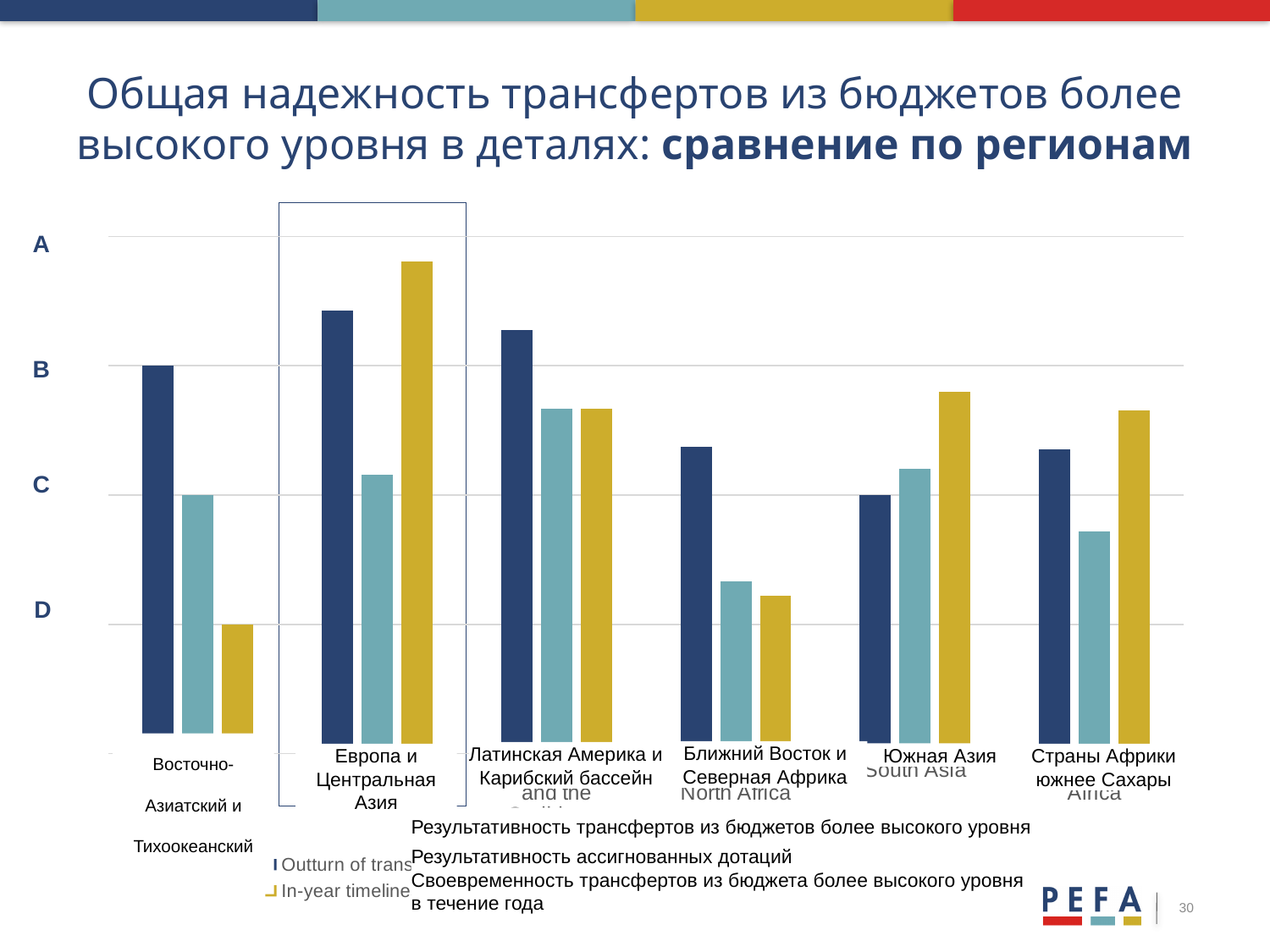
How many regions (categories) are shown on the x axis of the chart? 6 Which grade line does the dark blue bar for Южная Азия reach? C What kind of chart is shown on the slide? Bar chart Which grade line does the gold bar for Восточно-Азиатский и Тихоокеанский reach? D Is the teal bar higher for Латинская Америка и Карибский бассейн or for Южная Азия? Латинская Америка и Карибский бассейн Which grade line does the dark blue bar for Восточно-Азиатский и Тихоокеанский reach? B Which region has the lowest bar for 'Своевременность трансфертов из бюджета более высокого уровня в течение года' (gold)? Восточно-Азиатский и Тихоокеанский How many series does the chart's legend list? 3 Which region has the highest bar for 'Результативность трансфертов из бюджетов более высокого уровня' (dark blue)? Европа и Центральная Азия Is the dark blue bar higher for Восточно-Азиатский и Тихоокеанский or for Европа и Центральная Азия? Европа и Центральная Азия Which region has the lowest bar for 'Результативность ассигнованных дотаций' (teal)? Ближний Восток и Северная Африка Which region has the tallest bar in the whole chart? Европа и Центральная Азия